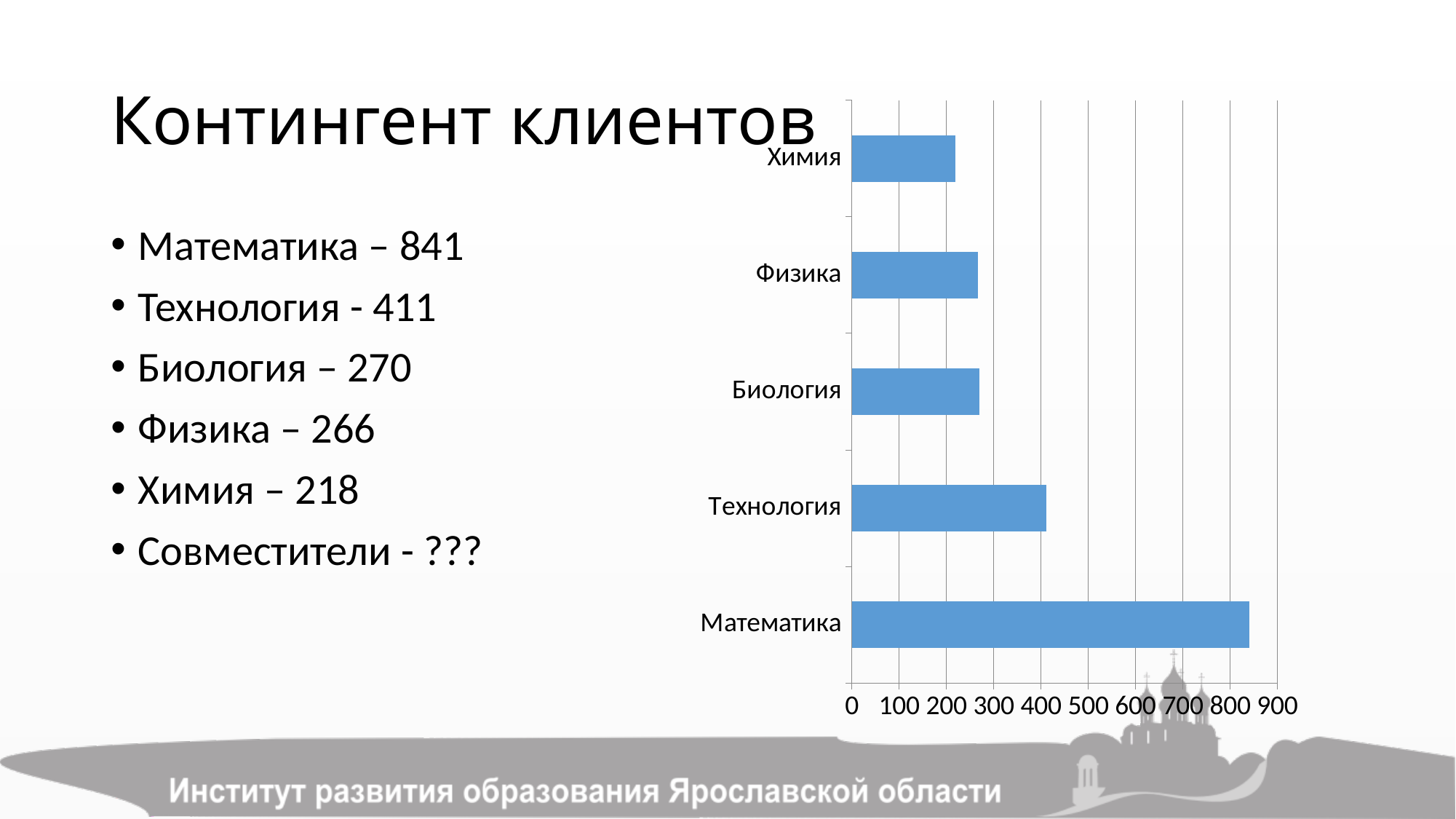
Is the value for Химия greater or less than 300? less What is the value for Математика? 841 Which category has the highest value in the chart? Математика How many categories does the chart show? 5 What is the value for Технология? 411 Which category has the lowest value in the chart? Химия What is the title of the slide containing the chart? Контингент клиентов What is the difference between the values for Математика and Технология? 430 Is the value for Математика greater or less than 800? greater Which is larger, the value for Технология or the value for Биология? Технология What kind of chart is shown on the slide? bar chart What is the value for Химия? 218